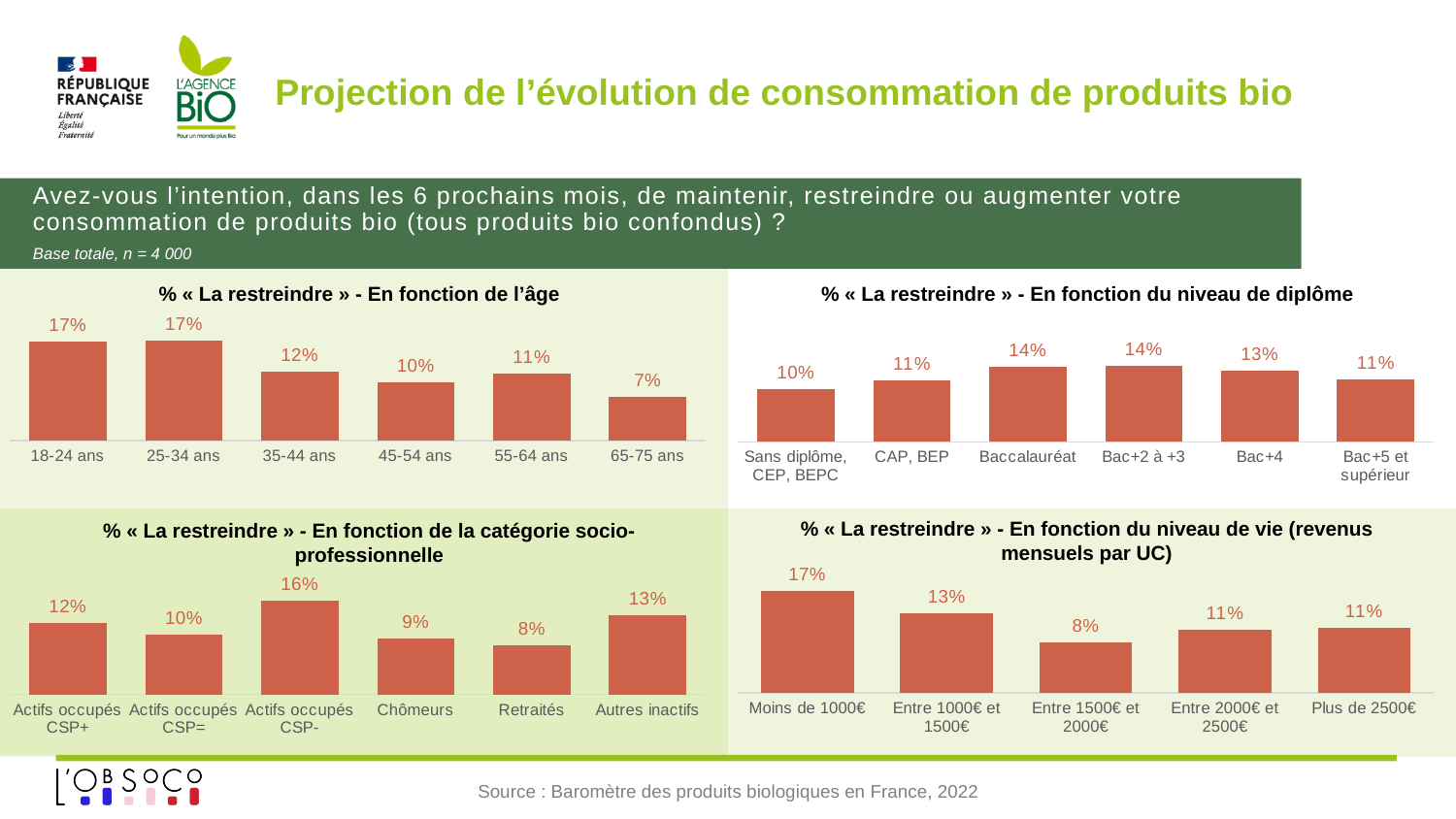
In the chart '% « La restreindre » - En fonction de l'âge', what is the value for 65-75 ans? 7% In the chart '% « La restreindre » - En fonction du niveau de diplôme', what is the value for Bac+4? 13% In the chart '% « La restreindre » - En fonction du niveau de vie (revenus mensuels par UC)', which income category has the lowest value? Entre 1500€ et 2000€ In the chart '% « La restreindre » - En fonction de la catégorie socio-professionnelle', which is larger, Chômeurs or Autres inactifs? Autres inactifs What type of chart is '% « La restreindre » - En fonction de l'âge'? Bar chart In the chart '% « La restreindre » - En fonction du niveau de diplôme', what is the difference between Baccalauréat and Sans diplôme, CEP, BEPC? 4 percentage points In the chart '% « La restreindre » - En fonction de la catégorie socio-professionnelle', what is the value for Retraités? 8% In the chart '% « La restreindre » - En fonction du niveau de vie (revenus mensuels par UC)', how many income categories are shown? 5 In the chart '% « La restreindre » - En fonction du niveau de vie (revenus mensuels par UC)', what is the value for Moins de 1000€? 17% In the chart '% « La restreindre » - En fonction de l'âge', which age group has the lowest value? 65-75 ans In the chart '% « La restreindre » - En fonction de l'âge', how many age categories are shown? 6 In the chart '% « La restreindre » - En fonction de la catégorie socio-professionnelle', which category has the highest value? Actifs occupés CSP-